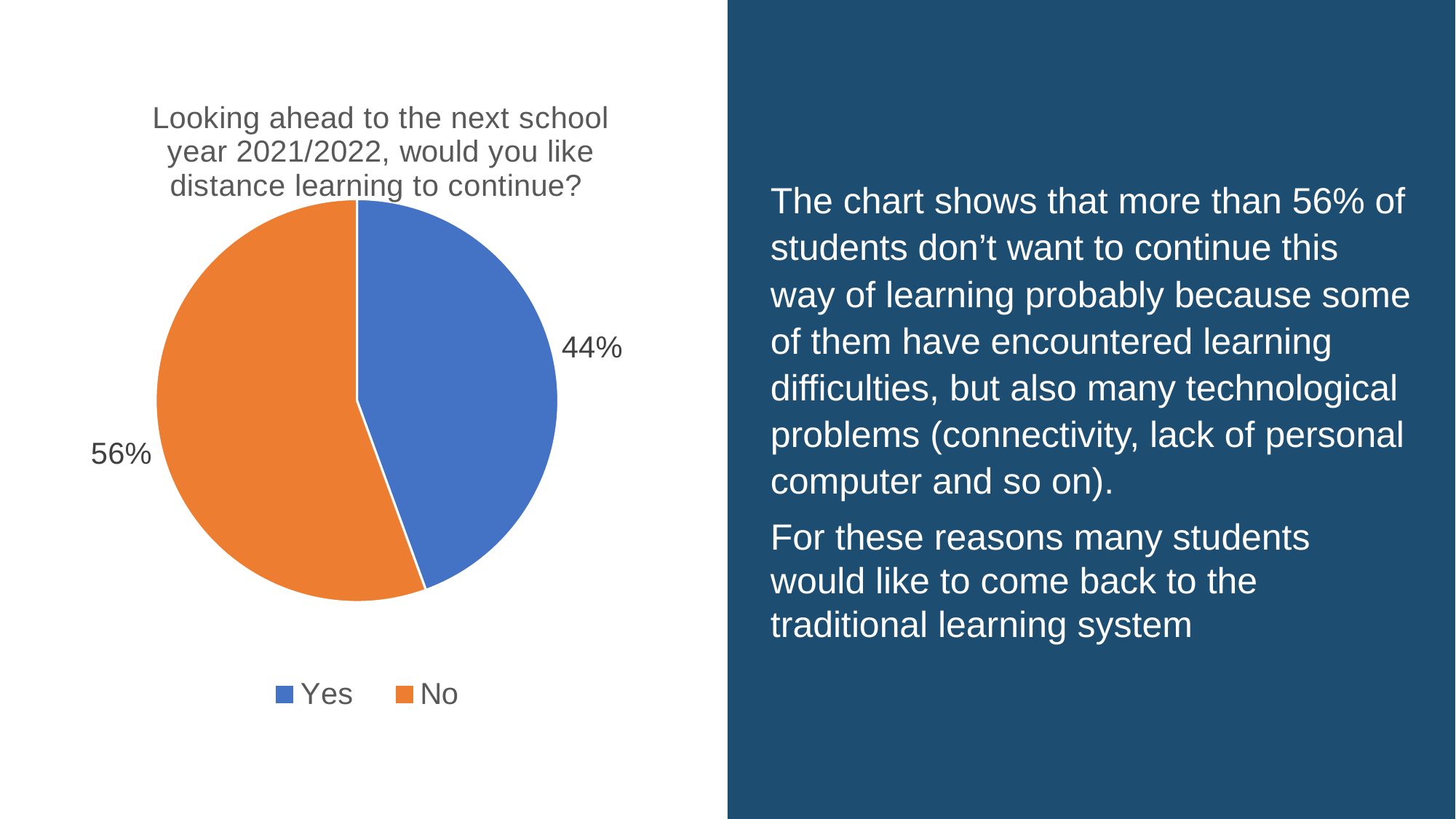
What share of the pie does the No slice represent? 56% Which colour represents the Yes slice in the pie chart? blue Which response has the larger share of the pie? No What is the difference in percentage points between the No and Yes slices? 12 percentage points Is the share for Yes larger or smaller than the share for No? smaller How many slices does the pie chart have? 2 What kind of chart is shown on the slide? pie chart How many entries does the legend list? 2 What percentage of respondents answered No? 56% What percentage of respondents answered Yes? 44% Which response has the smaller share of the pie? Yes What is the title of the pie chart? Looking ahead to the next school year 2021/2022, would you like distance learning to continue?